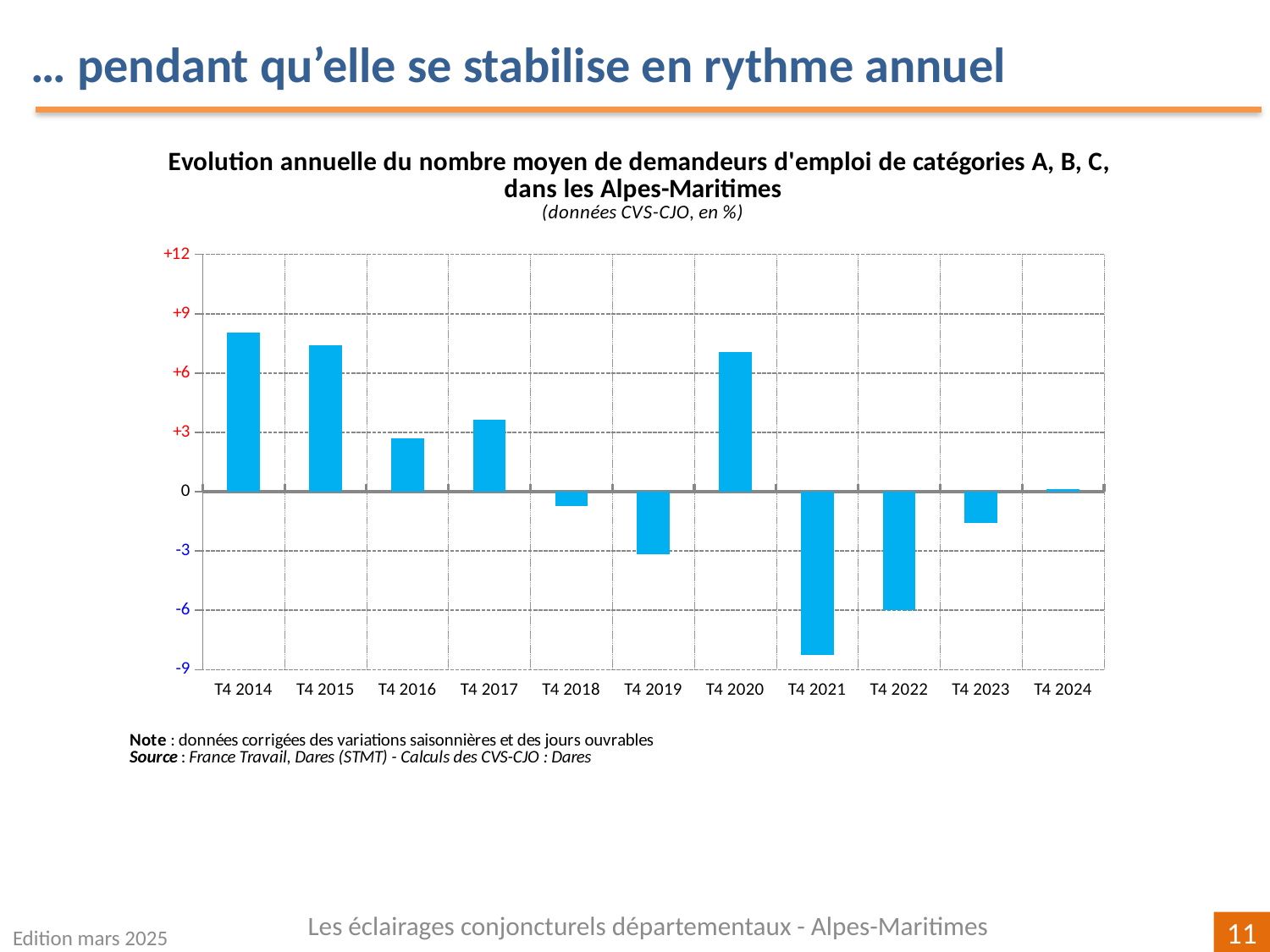
Which quarter has the highest value in the chart? T4 2014 What kind of chart is shown on the slide? bar chart Is the value for T4 2020 greater or less than +6? greater Which has the larger value, T4 2020 or T4 2016? T4 2020 In what unit are the data in the chart expressed, according to the subtitle? % Which has the lower value, T4 2021 or T4 2022? T4 2021 Is the value for T4 2023 greater or less than -3? greater Which quarter has the lowest value in the chart? T4 2021 Is the value for T4 2014 greater or less than +6? greater How many quarters (categories) are shown on the x axis of the chart? 11